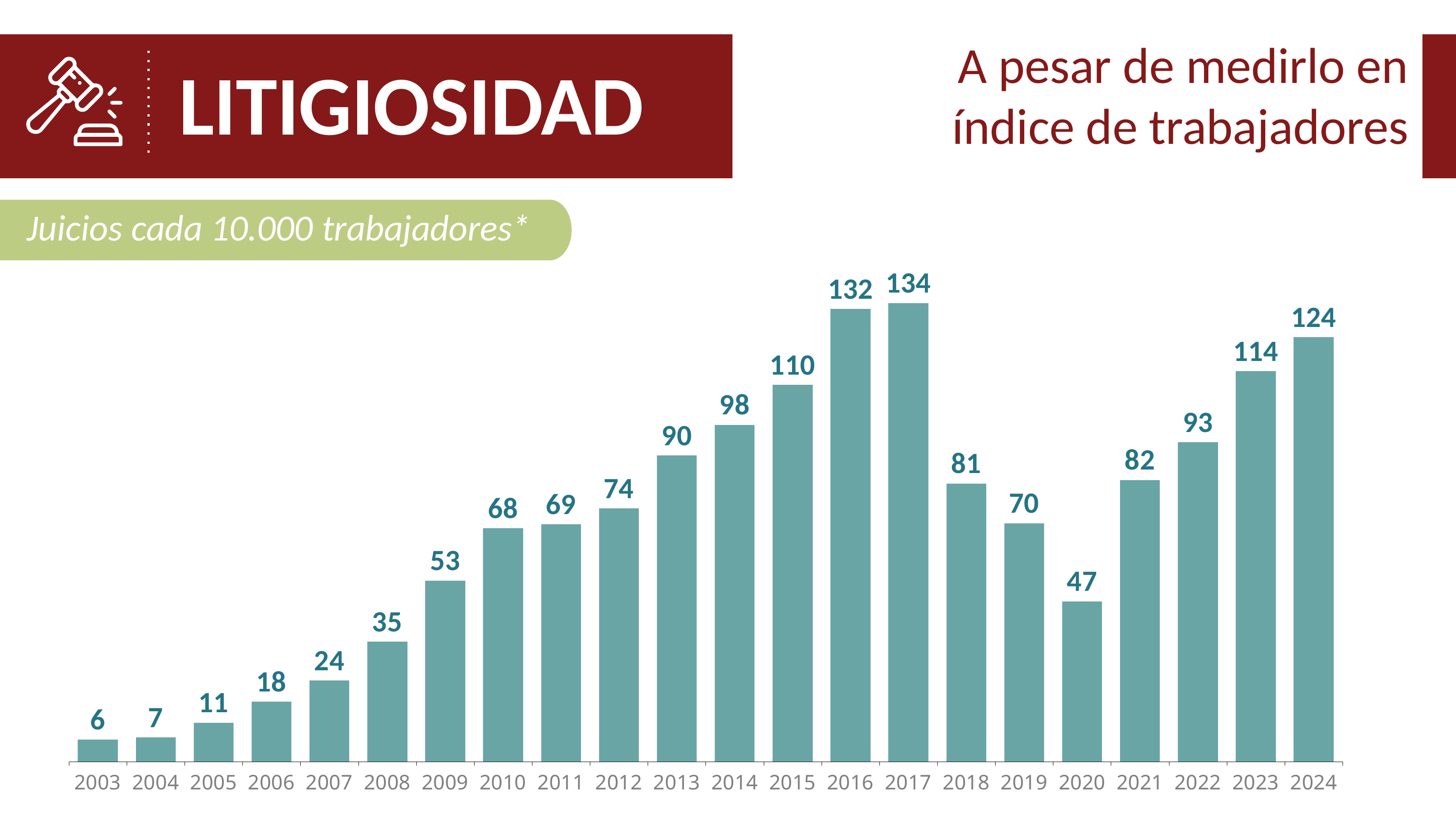
What is the difference between the values for 2017 and 2018? 53 What kind of chart is this? Bar chart What is the difference between the values for 2024 and 2023? 10 What is the subtitle describing the unit of the chart? Juicios cada 10.000 trabajadores* What is the value for 2020? 47 What is the value for 2024? 124 Which year has the highest value? 2017 Which is larger, the value for 2016 or the value for 2024? 2016 What is the value for 2017? 134 How many years are shown on the x axis? 22 Do the values rise or fall from 2003 to 2017? Rise Which year has the lowest value? 2003